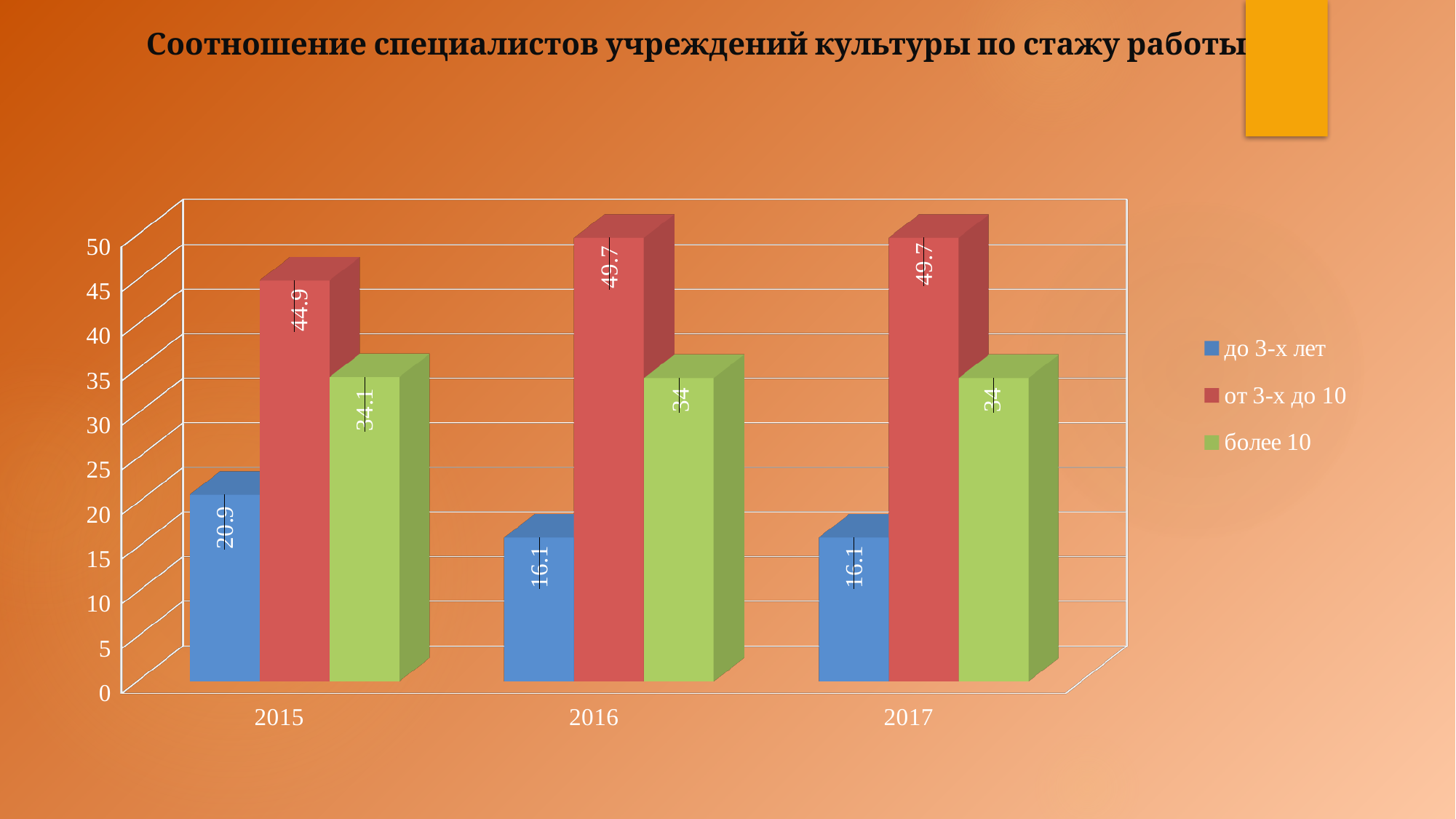
Which series has the highest value in 2017? от 3-х до 10 What is the difference between 'от 3-х до 10' and 'более 10' in 2015? 10.8 What is the value for 'от 3-х до 10' in 2016? 49.7 How many series does the legend list? 3 Does the value for 'до 3-х лет' rise or fall from 2015 to 2017? fall What kind of chart is shown? bar chart What is the value for 'от 3-х до 10' in 2015? 44.9 Which is larger: 'до 3-х лет' in 2015 or 'до 3-х лет' in 2016? до 3-х лет in 2015 What is the value for 'более 10' in 2017? 34 How many years are shown on the x axis? 3 What is the value for 'до 3-х лет' in 2015? 20.9 Which series has the lowest value in 2016? до 3-х лет